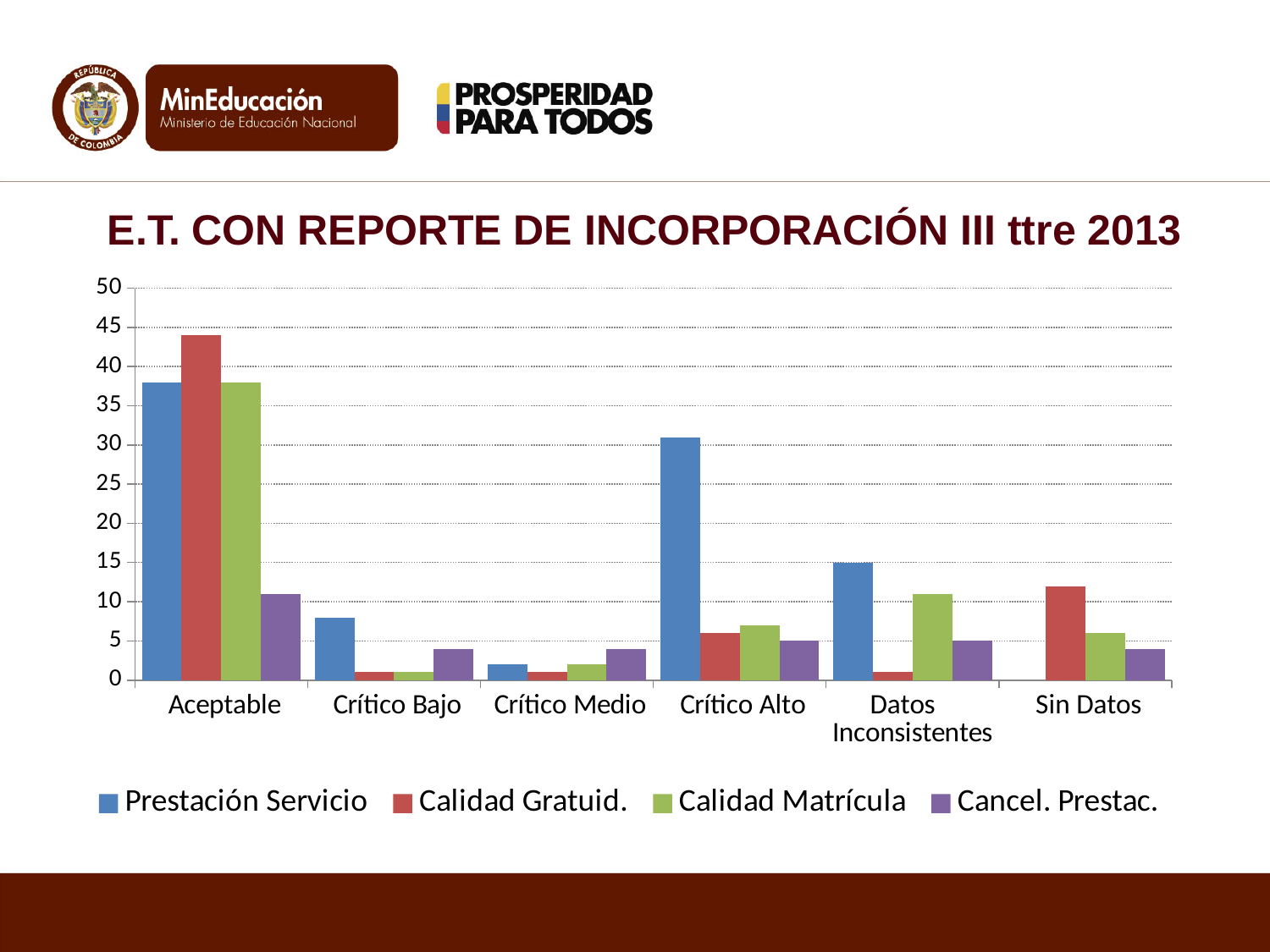
Which series has the lowest value in the Datos Inconsistentes category? Calidad Gratuid. Is the value for Calidad Gratuid. in the Aceptable category greater or less than 40? greater Which series has the highest value in the Aceptable category? Calidad Gratuid. Which is larger for Prestación Servicio: Crítico Alto or Datos Inconsistentes? Crítico Alto Is the value for Prestación Servicio in the Crítico Alto category greater or less than 25? greater Is the value for Calidad Gratuid. in the Sin Datos category greater or less than 15? less How many categories are shown along the x axis? 6 How many series does the legend list? 4 Which category has the highest value for Prestación Servicio? Aceptable What kind of chart is shown on the slide? Bar chart What is the title of the chart? E.T. CON REPORTE DE INCORPORACIÓN III ttre 2013